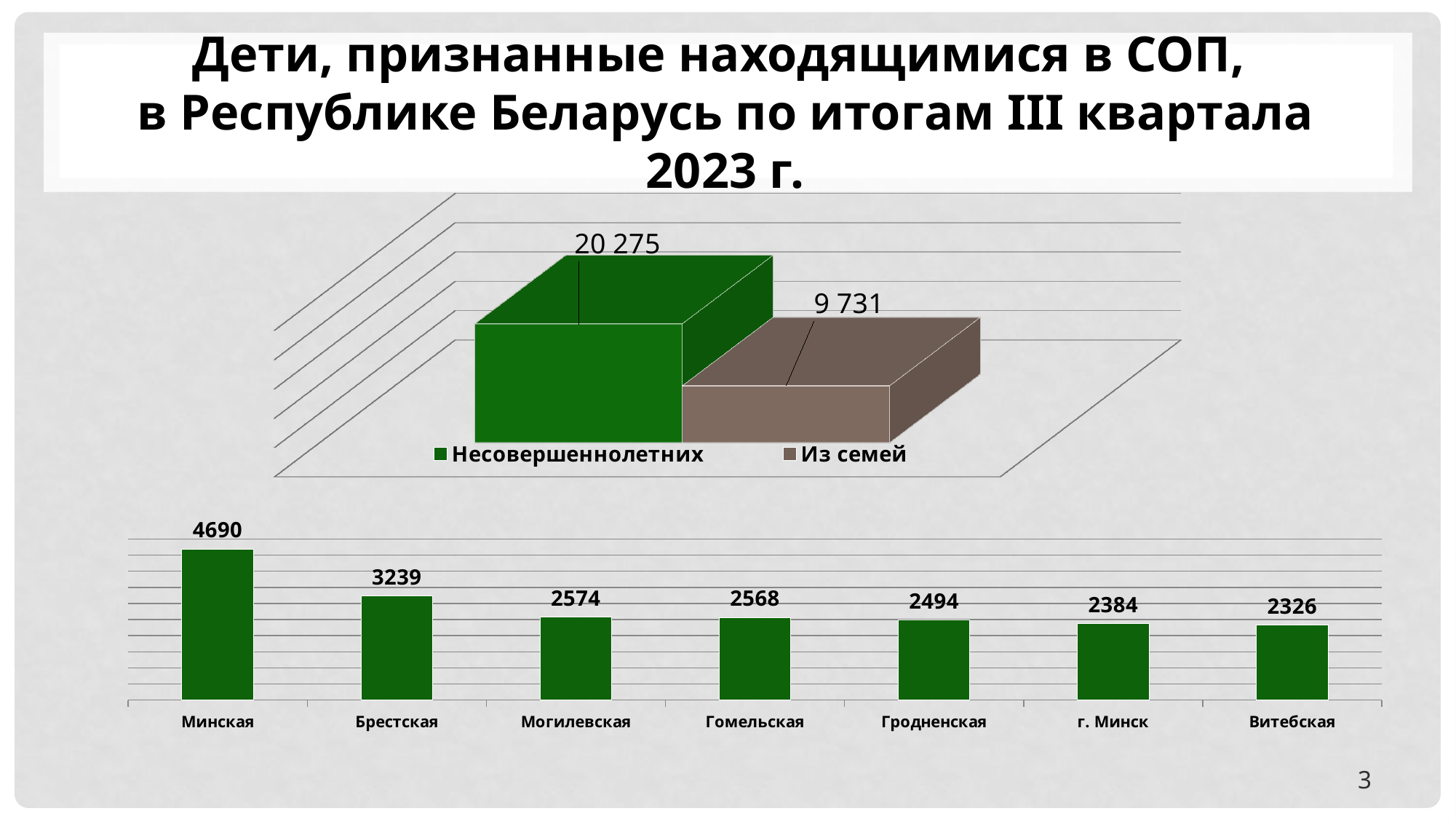
In the top chart, how many series does the legend list? 2 In the top chart, which series has the larger value, Несовершеннолетних or Из семей? Несовершеннолетних In the bottom chart, what is the value for Минская? 4690 In the top chart, what is the difference between Несовершеннолетних and Из семей? 10 544 In the top chart, what is the value for Из семей? 9 731 In the bottom chart, how many regions are shown? 7 In the bottom chart, which region has the lowest value? Витебская In the bottom chart, which region has the highest value? Минская In the top chart, what is the value for Несовершеннолетних? 20 275 What kind of chart is the bottom chart? Bar chart In the bottom chart, what is the difference between Минская and Брестская? 1451 In the bottom chart, what is the value for г. Минск? 2384